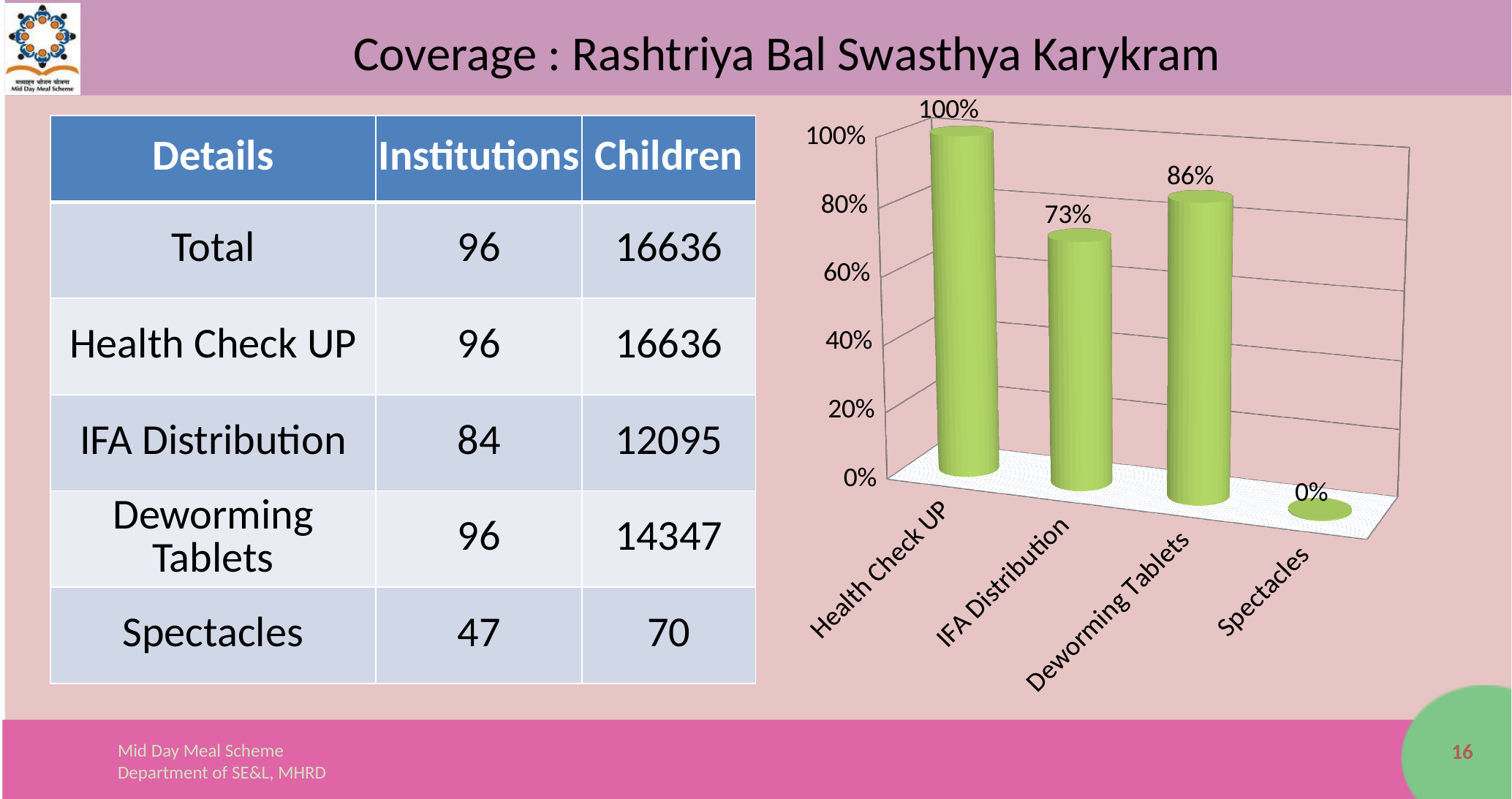
Is the value for IFA Distribution greater or less than 80%? less How many categories are shown on the x axis of the chart? 4 Which category has the lowest value in the chart? Spectacles What is the value for Deworming Tablets in the chart? 86% What kind of chart is shown on the slide? bar chart Which category has the highest value in the chart? Health Check UP What is the value for IFA Distribution in the chart? 73% Which is larger, the value for IFA Distribution or the value for Deworming Tablets? Deworming Tablets What is the value for Spectacles in the chart? 0% What is the value for Health Check UP in the chart? 100% What is the difference between the values for Deworming Tablets and IFA Distribution? 13% What is the difference between the values for Health Check UP and IFA Distribution? 27%